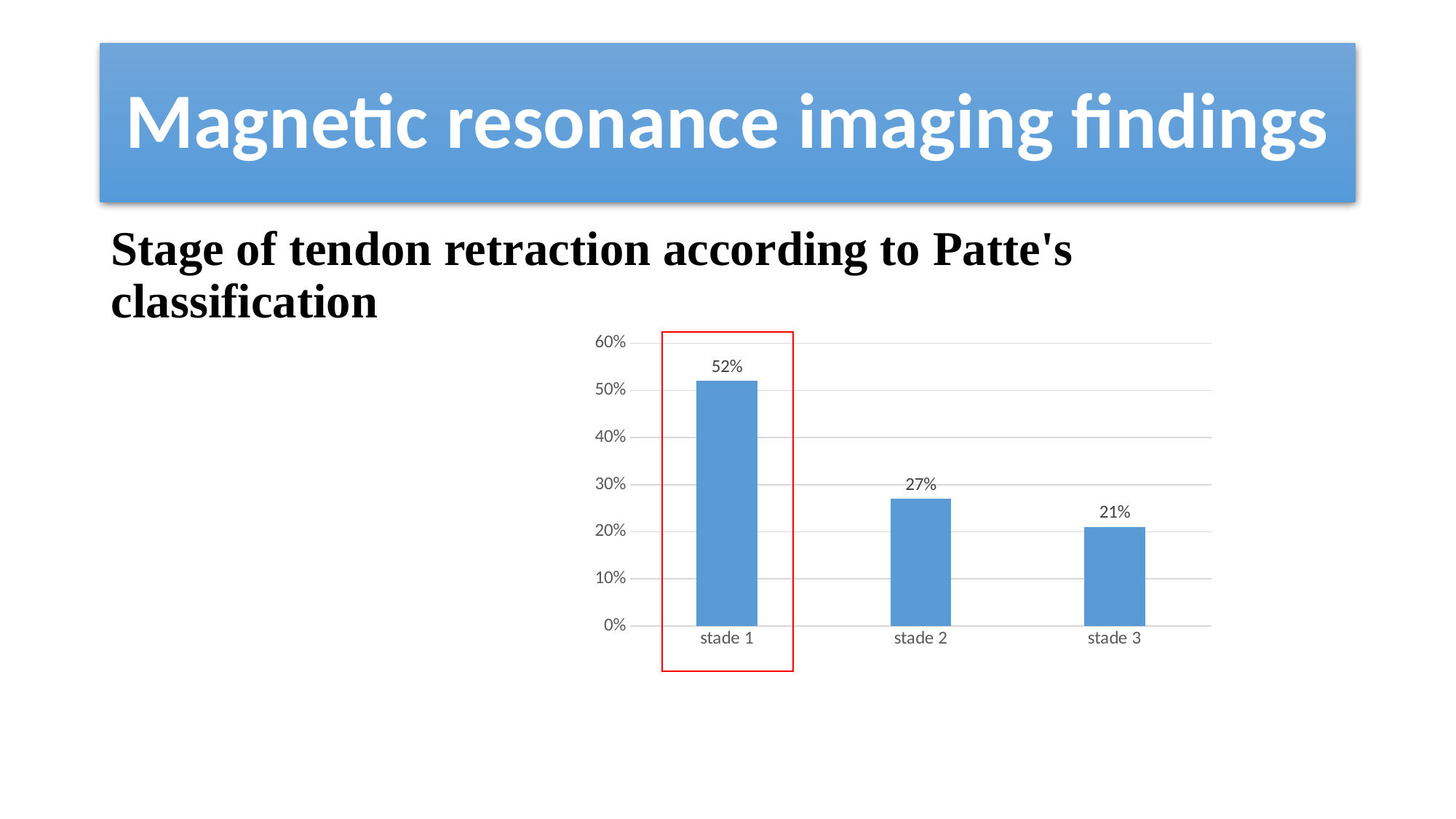
Do the values rise or fall from stade 1 to stade 3? fall What is the value for stade 2? 27% What is the difference between the values for stade 2 and stade 3? 6% What is the difference between the values for stade 1 and stade 2? 25% What is the value for stade 3? 21% Is the value for stade 1 greater or less than 50%? greater What kind of chart is shown on the slide? bar chart What is the value for stade 1? 52% Which stage has the lowest value? stade 3 Which stage has the highest value? stade 1 How many categories are shown on the chart? 3 Which is larger, the value for stade 2 or stade 3? stade 2